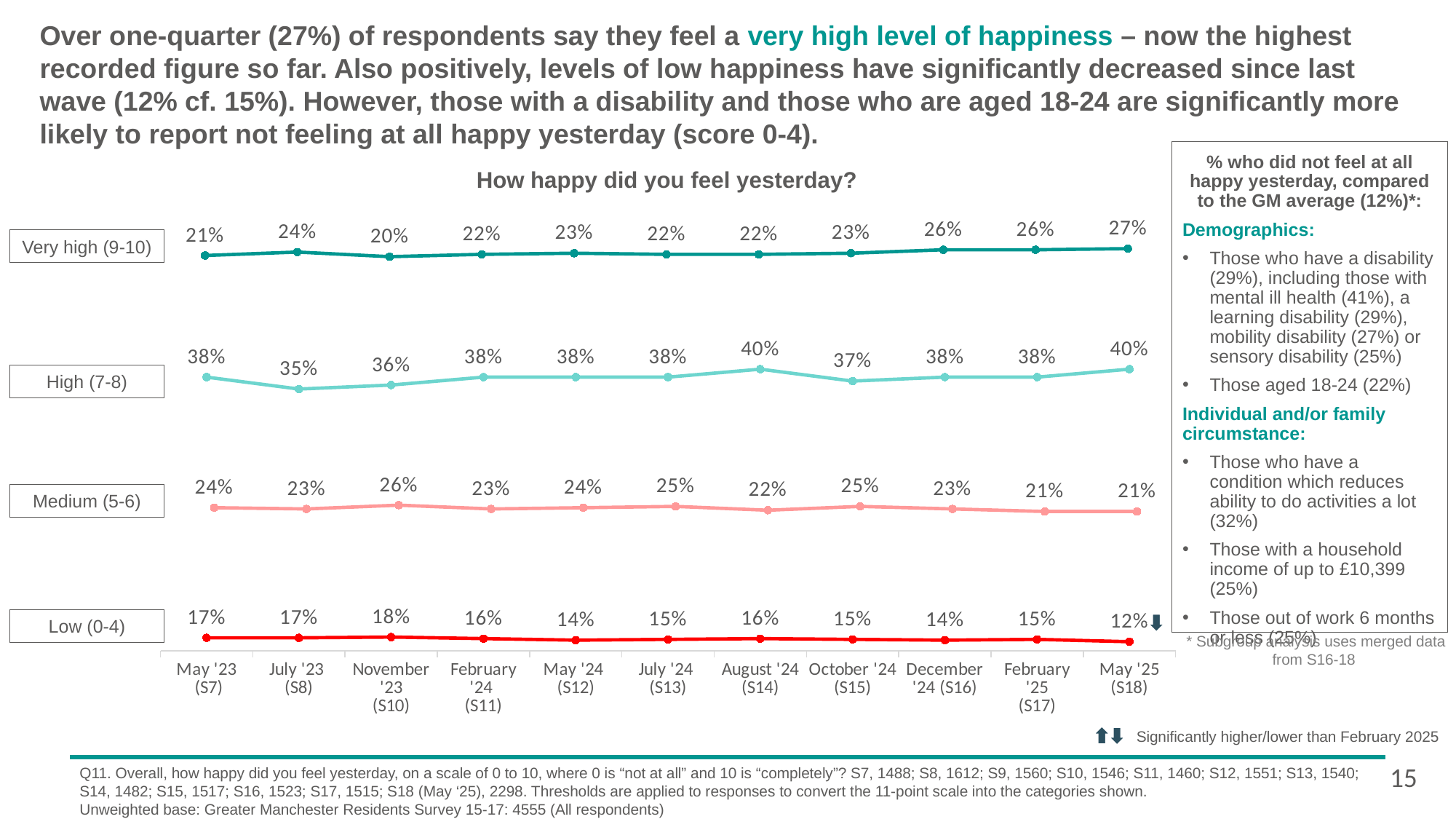
What is the value for Low (0-4) in May '23 (S7)? 17% In which survey wave does the Very high (9-10) series reach its lowest value? November '23 (S10) In which survey wave does the Low (0-4) series reach its lowest value? May '25 (S18) How many survey waves are plotted along the x axis? 11 What type of chart is used to show 'How happy did you feel yesterday?' Line chart Which is larger in August '24 (S14): the High (7-8) value or the Medium (5-6) value? High (7-8) What is the value for High (7-8) in July '23 (S8)? 35% What is the value for Medium (5-6) in November '23 (S10)? 26% What is the difference between the Low (0-4) value in February '25 (S17) and in May '25 (S18)? 3 percentage points What percentage of respondents reported a very high level of happiness (9-10) in May '25 (S18)? 27% How many series (happiness categories) are plotted on the chart? 4 Does the Very high (9-10) series rise or fall between December '24 (S16) and May '25 (S18)? Rise